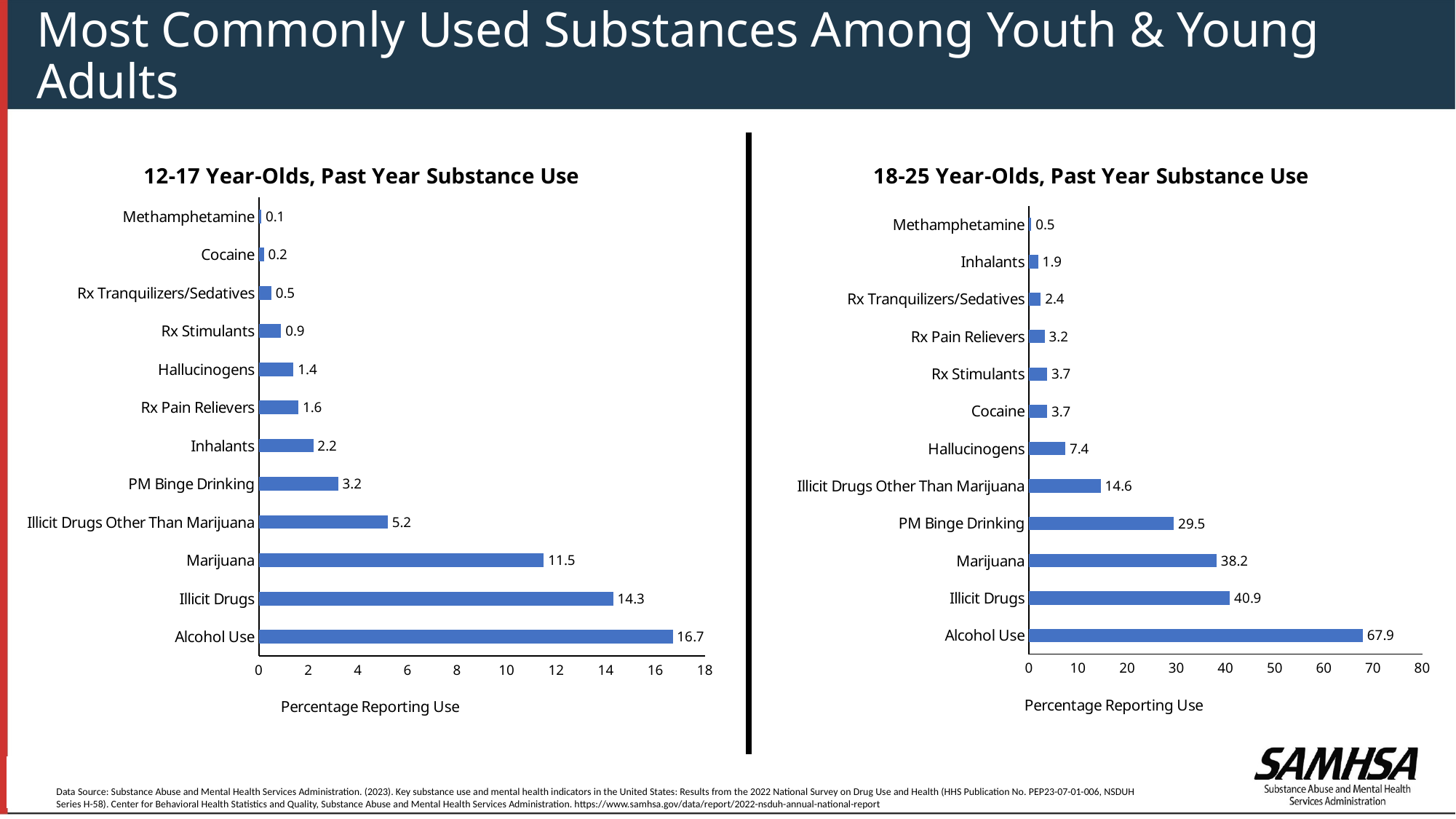
In the '12-17 Year-Olds, Past Year Substance Use' chart, which category has the lowest value? Methamphetamine In the '18-25 Year-Olds, Past Year Substance Use' chart, is the value for Alcohol Use greater or less than 60? greater In the '12-17 Year-Olds, Past Year Substance Use' chart, what is the value for Rx Stimulants? 0.9 In the '18-25 Year-Olds, Past Year Substance Use' chart, what is the difference between Illicit Drugs and Marijuana? 2.7 What kind of chart is the '18-25 Year-Olds, Past Year Substance Use' chart? Bar chart In the '18-25 Year-Olds, Past Year Substance Use' chart, which category has the highest value? Alcohol Use What is the x-axis label of the '18-25 Year-Olds, Past Year Substance Use' chart? Percentage Reporting Use In the '12-17 Year-Olds, Past Year Substance Use' chart, what is the value for Marijuana? 11.5 In the '18-25 Year-Olds, Past Year Substance Use' chart, what is the value for PM Binge Drinking? 29.5 In the '12-17 Year-Olds, Past Year Substance Use' chart, which is larger: Inhalants or Hallucinogens? Inhalants In the '12-17 Year-Olds, Past Year Substance Use' chart, what is the difference between Alcohol Use and Illicit Drugs? 2.4 How many categories are shown in the '12-17 Year-Olds, Past Year Substance Use' chart? 12